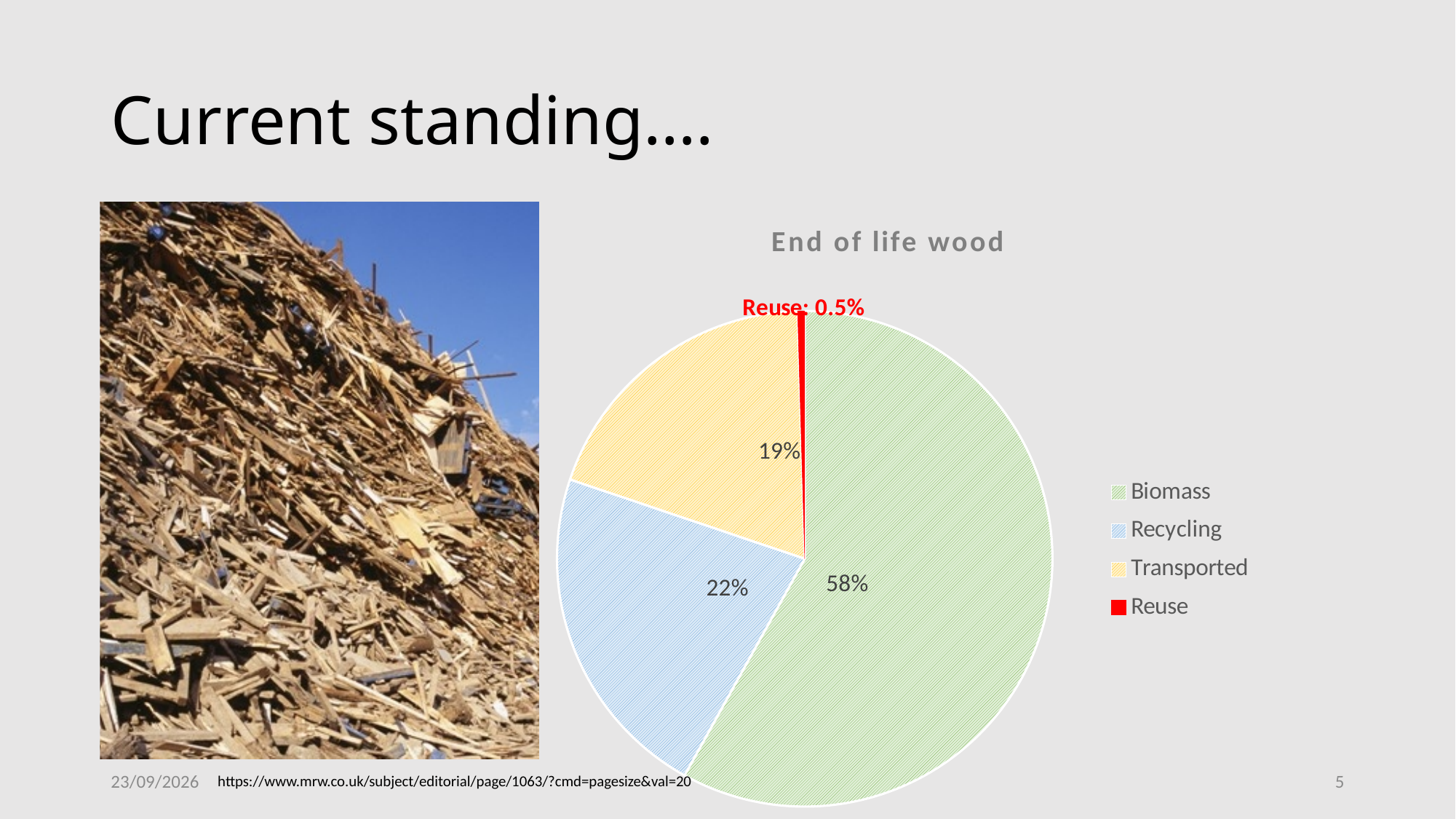
What share of end of life wood is Reused? 0.5% What type of chart is shown on the slide? pie chart What share of end of life wood is Transported? 19% Which category has the largest share of the pie? Biomass What is the difference in percentage points between the Biomass share and the Recycling share? 36% Which category has the smallest share of the pie? Reuse How many categories does the pie chart show? 4 What is the title of the pie chart? End of life wood Which is larger, the share for Recycling or the share for Transported? Recycling Which colour represents Reuse in the pie chart? red What share of end of life wood goes to Recycling? 22% What share of end of life wood goes to Biomass? 58%